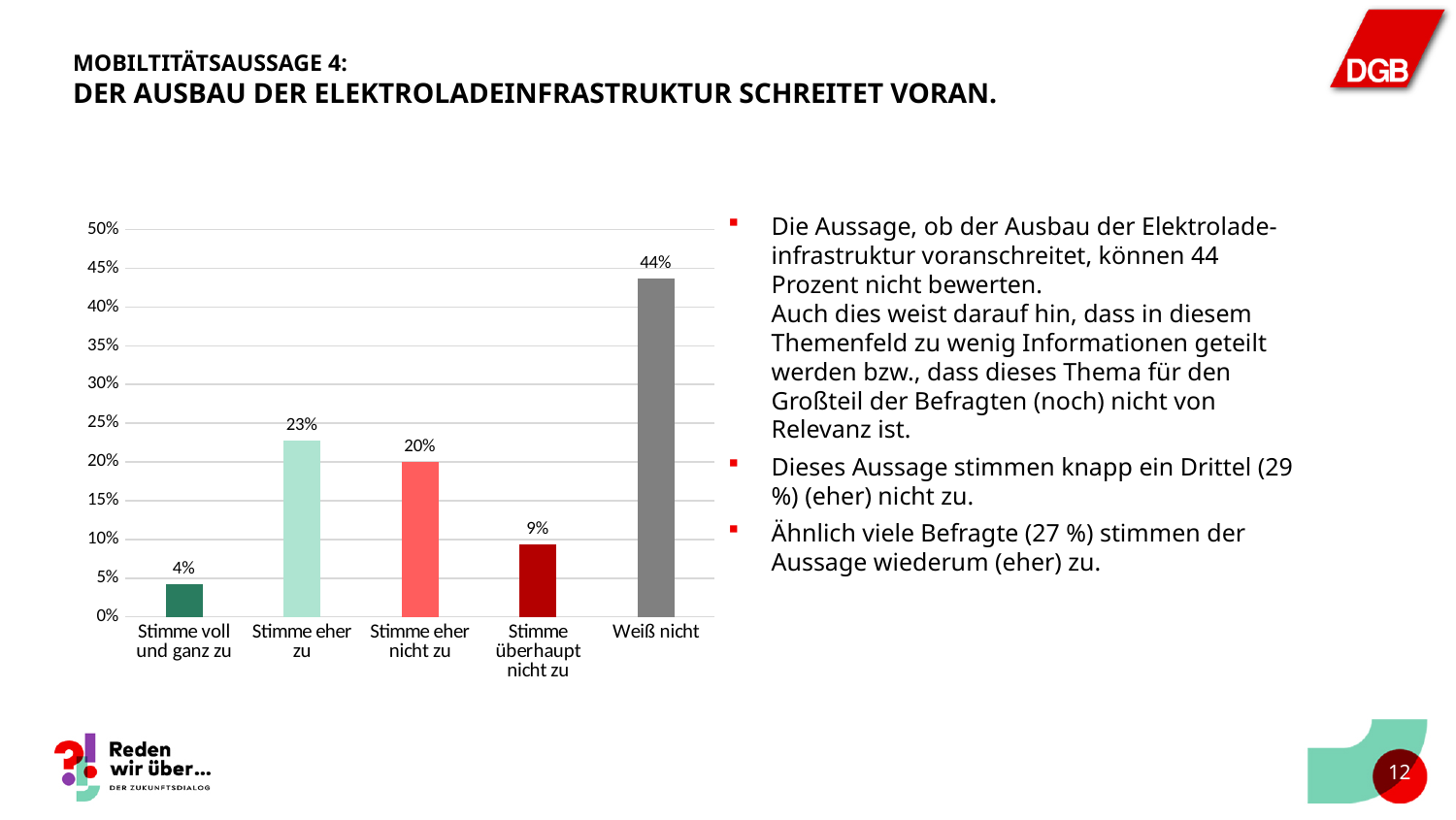
What is the value for "Stimme überhaupt nicht zu"? 9% Which category has the highest value? Weiß nicht What kind of chart is shown on the slide? Bar chart What is the value for "Stimme eher zu"? 23% How many categories are shown on the x axis? 5 Is the value for "Weiß nicht" greater or less than 40%? greater Which category has the lowest value? Stimme voll und ganz zu What is the value for "Stimme voll und ganz zu"? 4% Which is larger, "Stimme eher zu" or "Stimme eher nicht zu"? Stimme eher zu What is the value for "Weiß nicht"? 44% What is the difference between "Stimme eher nicht zu" and "Stimme überhaupt nicht zu"? 11% What is the difference between "Weiß nicht" and "Stimme eher zu"? 21%